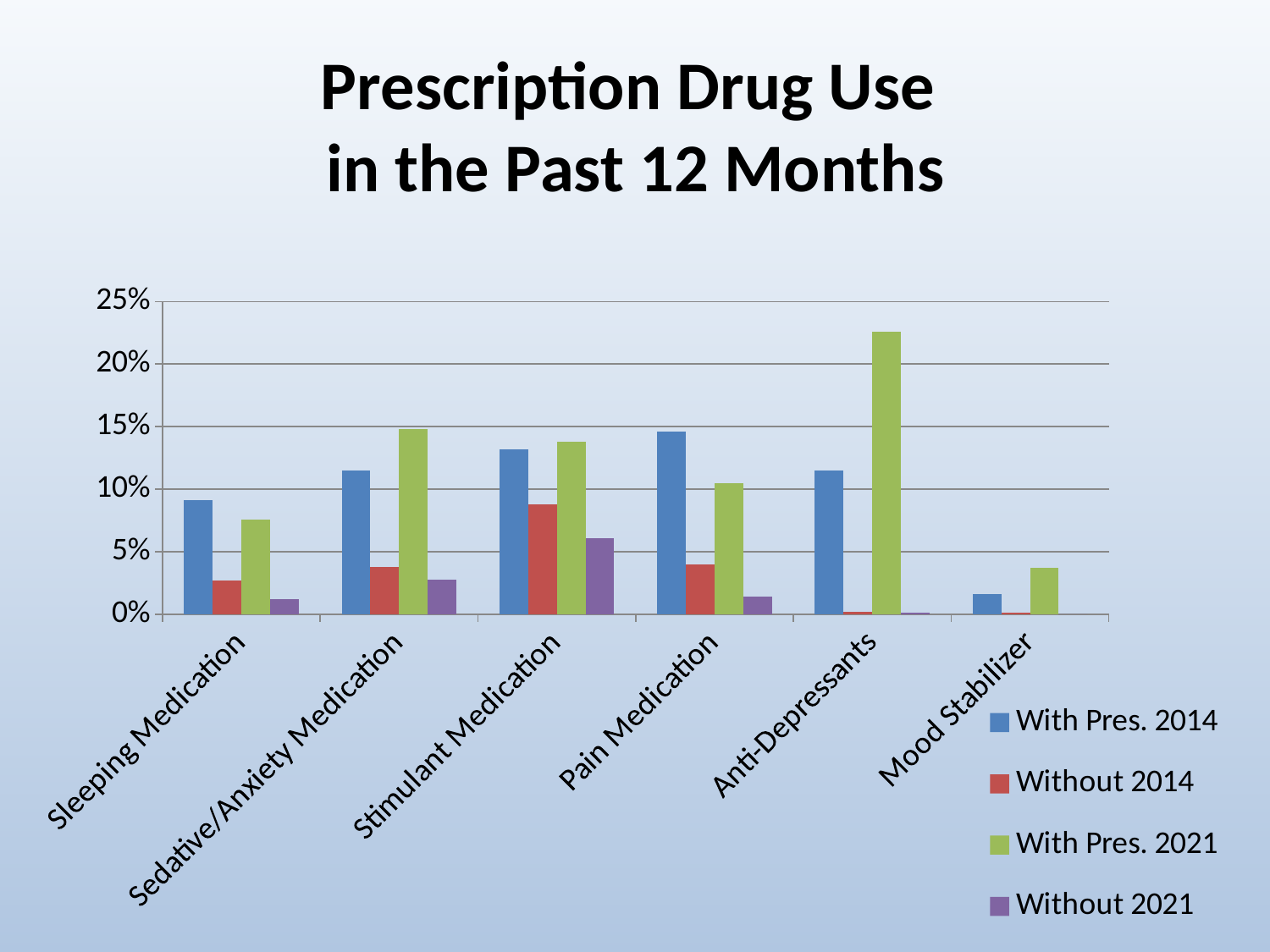
Which category has the lowest With Pres. 2014 bar? Mood Stabilizer Is the With Pres. 2021 value for Anti-Depressants greater or less than 20%? greater Which category has the highest Without 2014 bar? Stimulant Medication Which category has the highest With Pres. 2014 bar? Pain Medication How many series does the legend list? 4 What is the title of the chart? Prescription Drug Use in the Past 12 Months For Sleeping Medication, which is larger: the With Pres. 2014 value or the With Pres. 2021 value? With Pres. 2014 Is the Without 2014 value for Stimulant Medication greater or less than 5%? greater How many medication categories are shown on the x axis? 6 Is the With Pres. 2021 value for Pain Medication greater or less than 15%? less Which category has the highest With Pres. 2021 bar? Anti-Depressants What kind of chart is shown on the slide? bar chart